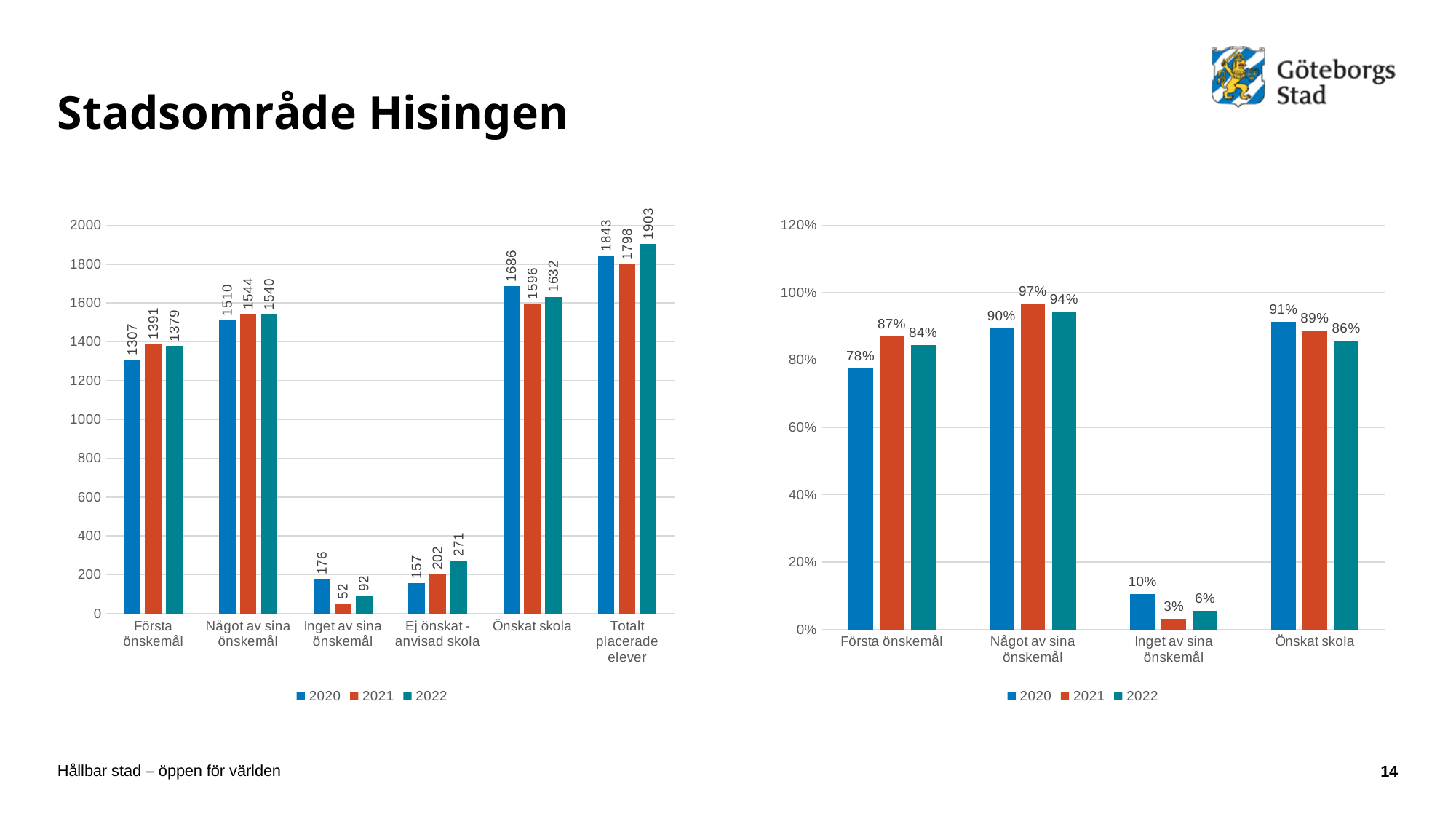
In the right chart, what is the difference between the 2020 and 2022 values for Önskat skola? 5% In the left chart, what is the value for 2022 for Totalt placerade elever? 1903 In the right chart, what is the value for 2021 for Något av sina önskemål? 97% What kind of chart is the right chart? Bar chart In the right chart, which category has the lowest value for 2022? Inget av sina önskemål In the left chart, what is the value for 2021 for Inget av sina önskemål? 52 How many categories are shown on the x axis of the right chart? 4 In the left chart, what is the difference between the 2022 and 2020 values for Ej önskat - anvisad skola? 114 In the left chart, which category has the highest value for 2020? Totalt placerade elever In the right chart, what is the value for 2020 for Första önskemål? 78% In the left chart, which is larger for Önskat skola: the 2020 value or the 2021 value? 2020 How many series does the legend of the left chart list? 3